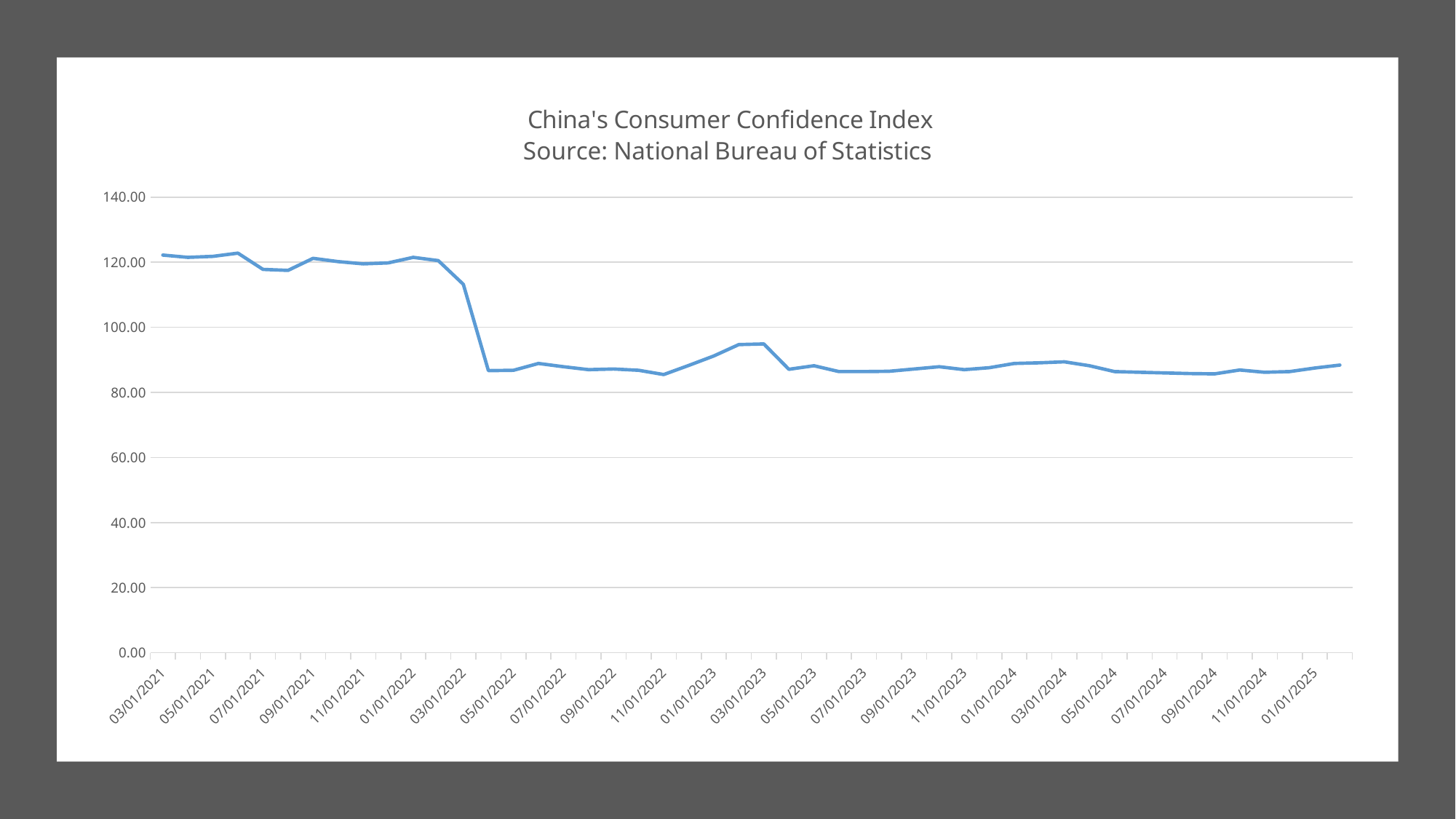
Is the value for 03/01/2023 greater or less than 100? less Is the value for 03/01/2021 greater or less than 100? greater How many date labels are shown on the x axis? 24 Is the value for 07/01/2024 greater or less than 80? greater What is the title of the chart? China's Consumer Confidence Index Which is larger, the value for 03/01/2023 or the value for 07/01/2023? 03/01/2023 According to the chart title, what is the source of the data? National Bureau of Statistics Overall, do the values rise or fall from the start of the x axis to the end? fall What kind of chart is shown on the slide? Line chart Which is larger, the value for 03/01/2021 or the value for 05/01/2022? 03/01/2021